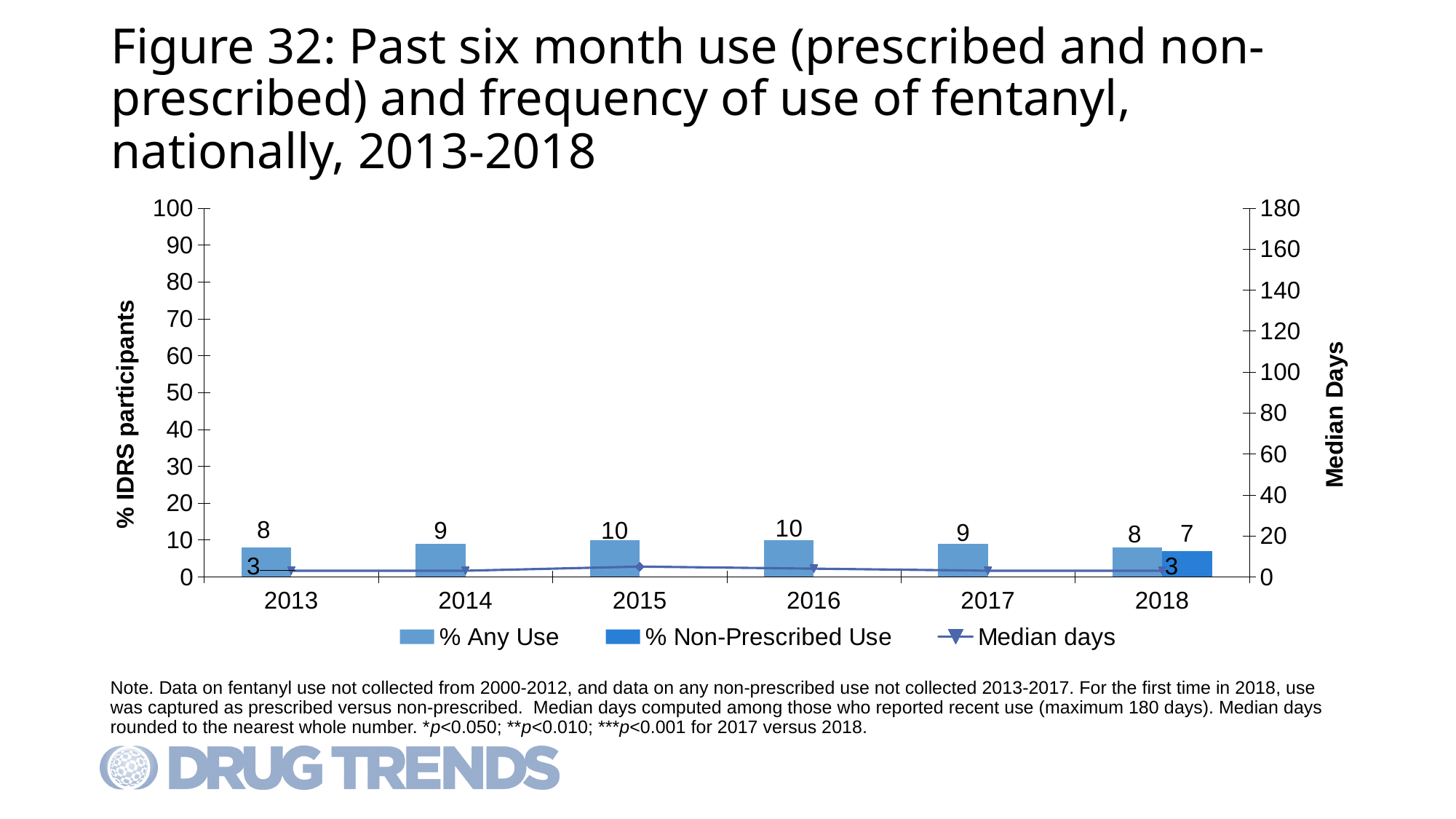
What is the % Non-Prescribed Use value for 2018? 7 What is the Median days value for 2018? 3 Which is larger in 2018: % Any Use or % Non-Prescribed Use? % Any Use Is the % Any Use value for 2016 greater or less than 20? less How many years are shown on the x axis? 6 Does the % Any Use value rise or fall from 2016 to 2018? fall How many series does the legend list? 3 What kind of chart is used for the % Any Use series? bar chart What is the % Any Use value for 2015? 10 What is the % Any Use value for 2013? 8 What is the label of the right-hand vertical axis? Median Days What is the difference between the % Any Use value for 2015 and the % Any Use value for 2013? 2